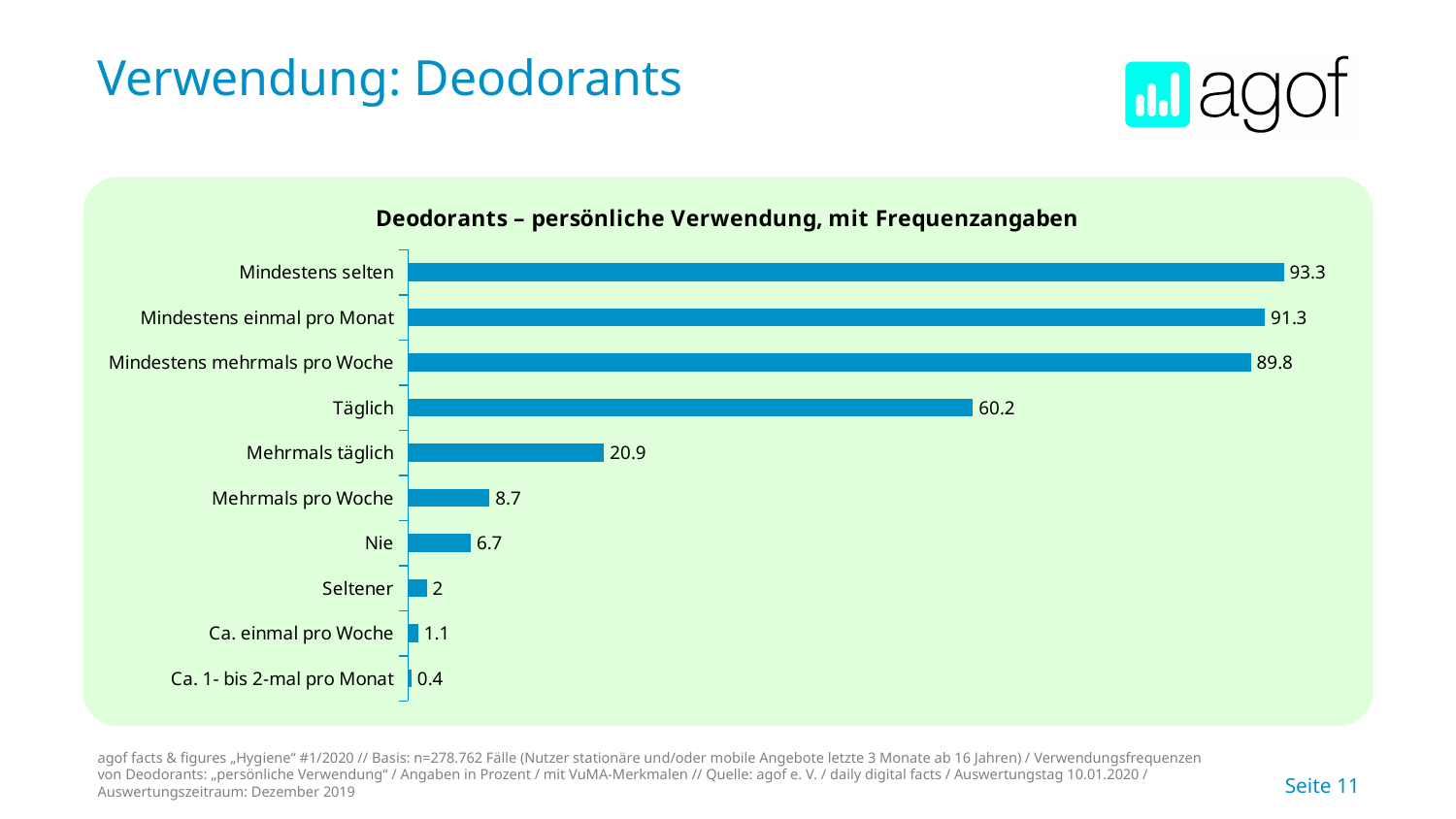
What is the difference between the values for "Mindestens selten" and "Täglich"? 33.1 How many categories are shown in the chart? 10 Which category has the lowest value? Ca. 1- bis 2-mal pro Monat What is the title of the chart? Deodorants – persönliche Verwendung, mit Frequenzangaben What is the value for "Täglich"? 60.2 What kind of chart is shown on the slide? Bar chart Which is larger, the value for "Mehrmals pro Woche" or the value for "Nie"? Mehrmals pro Woche What is the difference between the values for "Seltener" and "Ca. einmal pro Woche"? 0.9 Which category has the highest value? Mindestens selten What is the value for "Mindestens mehrmals pro Woche"? 89.8 What is the value for "Nie"? 6.7 What is the value for "Mehrmals täglich"? 20.9